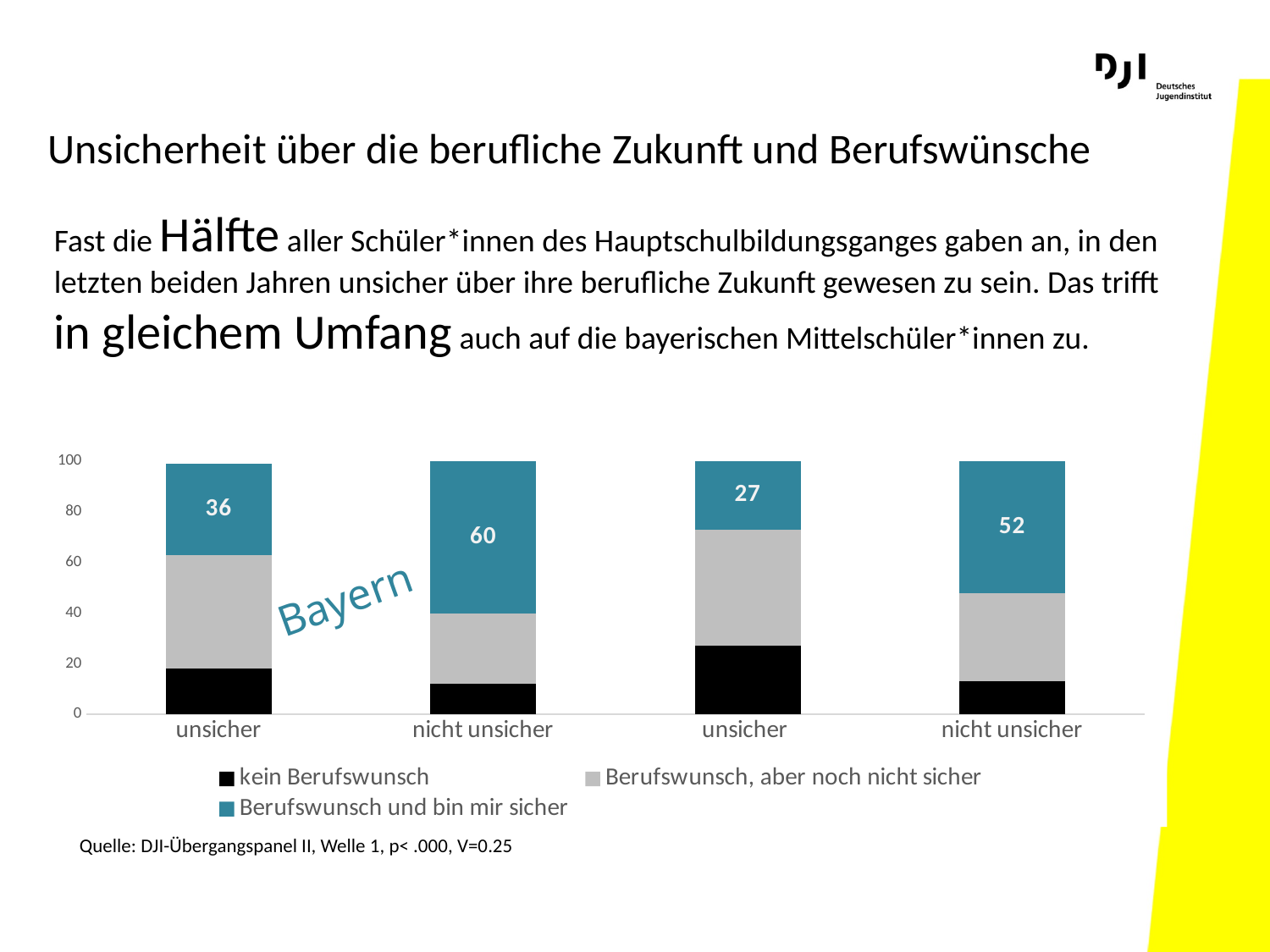
Which bar has the lowest labelled 'Berufswunsch und bin mir sicher' value? unsicher (right pair) Is the 'kein Berufswunsch' segment of the 'unsicher' bar in the right pair greater or less than 20? greater In the stacked bar chart, what is the labelled value of the 'Berufswunsch und bin mir sicher' segment for the 'unsicher' bar in the right pair? 27 In the stacked bar chart, what is the labelled value of the 'Berufswunsch und bin mir sicher' segment for the 'nicht unsicher' bar in the right pair? 52 How many bars are plotted in the chart? 4 In the stacked bar chart, what is the labelled value of the 'Berufswunsch und bin mir sicher' segment for the 'unsicher' bar in the left (Bayern) pair? 36 What is the difference between the 'Berufswunsch und bin mir sicher' values of the 'nicht unsicher' and 'unsicher' bars in the left (Bayern) pair? 24 Which bar has the highest labelled 'Berufswunsch und bin mir sicher' value? nicht unsicher (left, Bayern pair) In the stacked bar chart, what is the labelled value of the 'Berufswunsch und bin mir sicher' segment for the 'nicht unsicher' bar in the left (Bayern) pair? 60 Which is larger: the 'Berufswunsch und bin mir sicher' value for 'unsicher' in the left (Bayern) pair or for 'unsicher' in the right pair? unsicher in the left (Bayern) pair What kind of chart is shown on the slide? stacked bar chart How many series does the legend list? 3